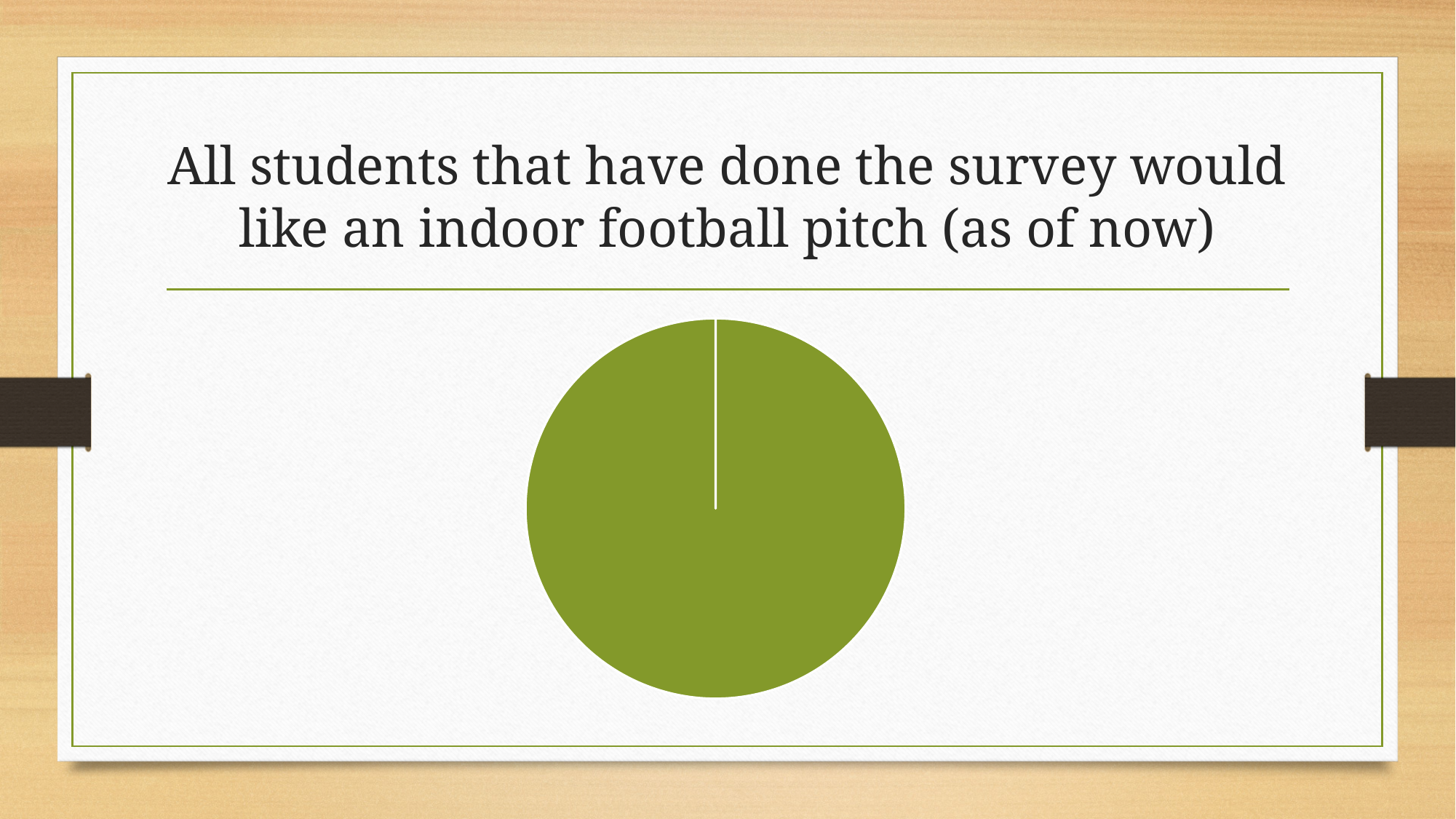
How many slices does the pie chart show? 1 Does the pie chart have a legend? No What kind of chart is shown on the slide? pie chart What colour is the pie chart? green Is the pie chart divided into multiple slices, or does a single slice fill the whole pie? a single slice fills the whole pie